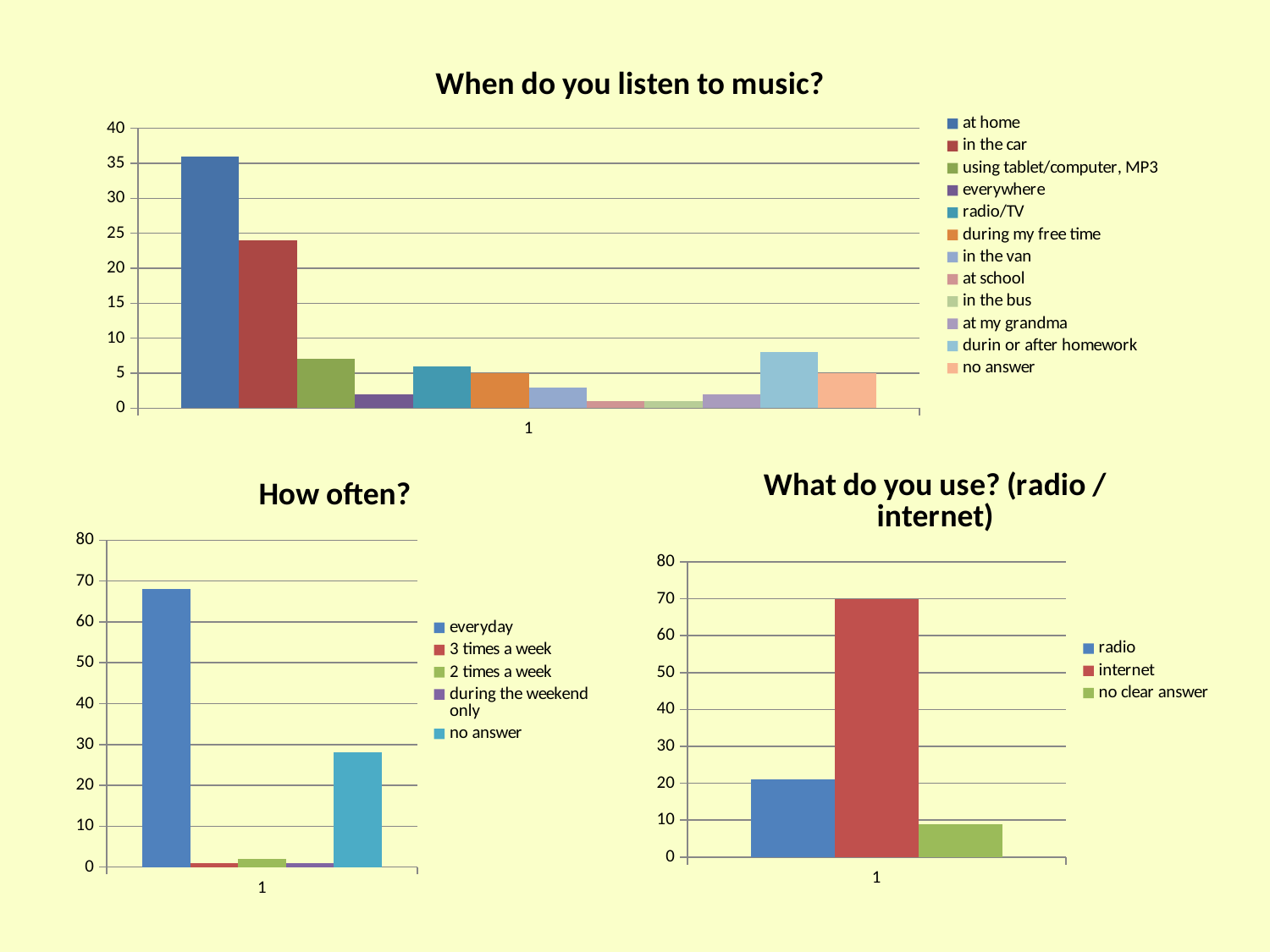
In the 'When do you listen to music?' chart, which is larger: 'in the car' or 'radio/TV'? in the car What kind of chart is the 'When do you listen to music?' chart? bar chart In the 'What do you use? (radio / internet)' chart, what is the value for 'internet'? 70 In the 'How often?' chart, how many series does the legend list? 5 What is the title of the chart at the top of the slide? When do you listen to music? In the 'How often?' chart, is the value for 'everyday' greater or less than 60? greater In the 'When do you listen to music?' chart, how many series does the legend list? 12 In the 'What do you use? (radio / internet)' chart, which series has the lowest value? no clear answer In the 'When do you listen to music?' chart, is the value for 'at home' greater or less than 30? greater In the 'How often?' chart, which series has the highest value? everyday In the 'What do you use? (radio / internet)' chart, is the value for 'radio' greater or less than 30? less In the 'When do you listen to music?' chart, which series has the highest value? at home